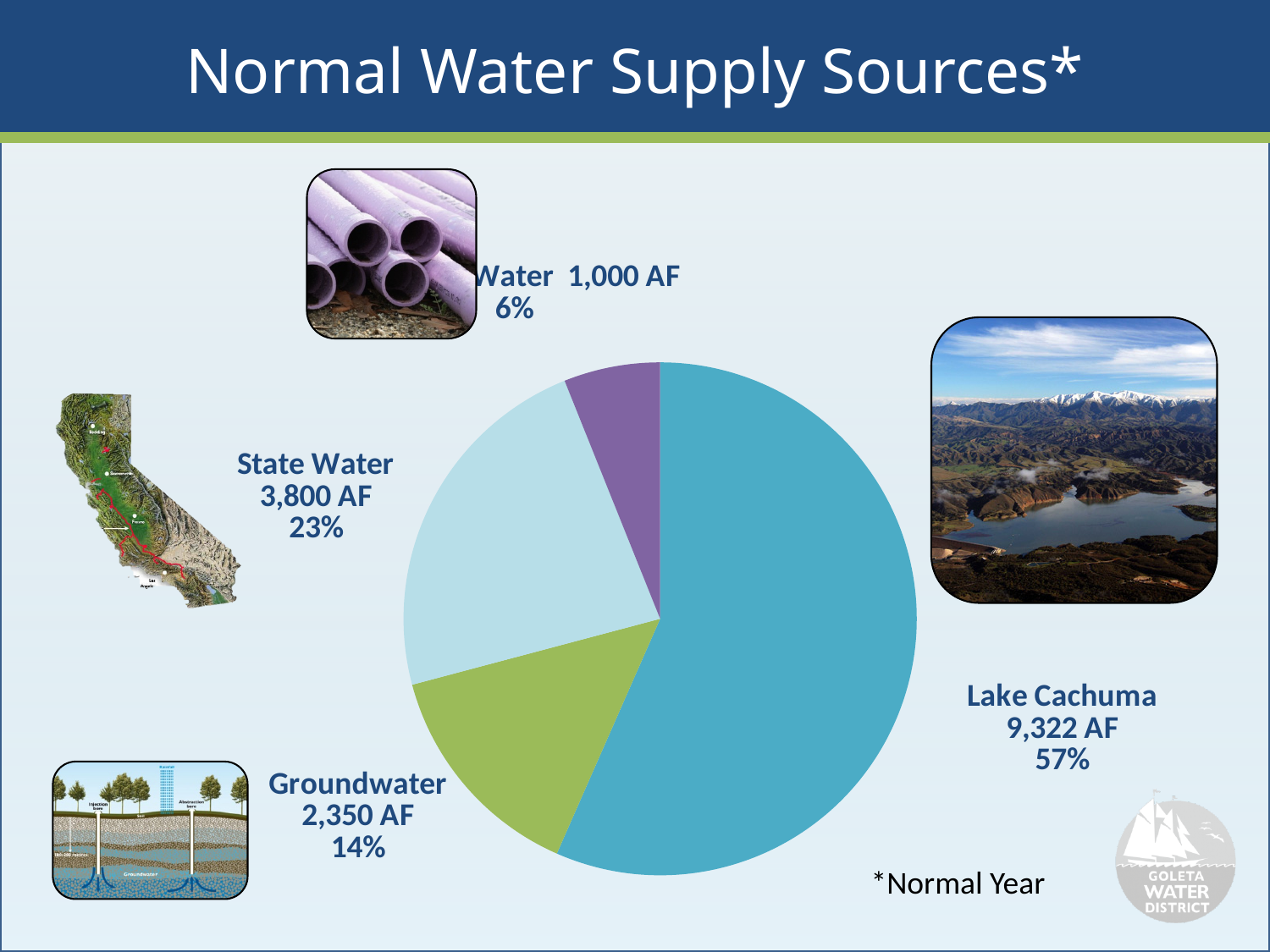
How many acre-feet does Lake Cachuma supply in a normal year? 9,322 AF Which is larger, State Water or Groundwater? State Water How many slices does the pie chart have? 4 What share of the pie does Lake Cachuma represent? 57% What kind of chart is shown on the slide? pie chart What percentage of the normal water supply comes from State Water? 23% What is the difference in acre-feet between State Water and Groundwater? 1,450 AF How many acre-feet come from Groundwater? 2,350 AF Which water supply source is the largest? Lake Cachuma What is the value shown for the purple slice of the pie chart? 1,000 AF What is the title of the slide containing the pie chart? Normal Water Supply Sources* What is the difference in acre-feet between Lake Cachuma and State Water? 5,522 AF